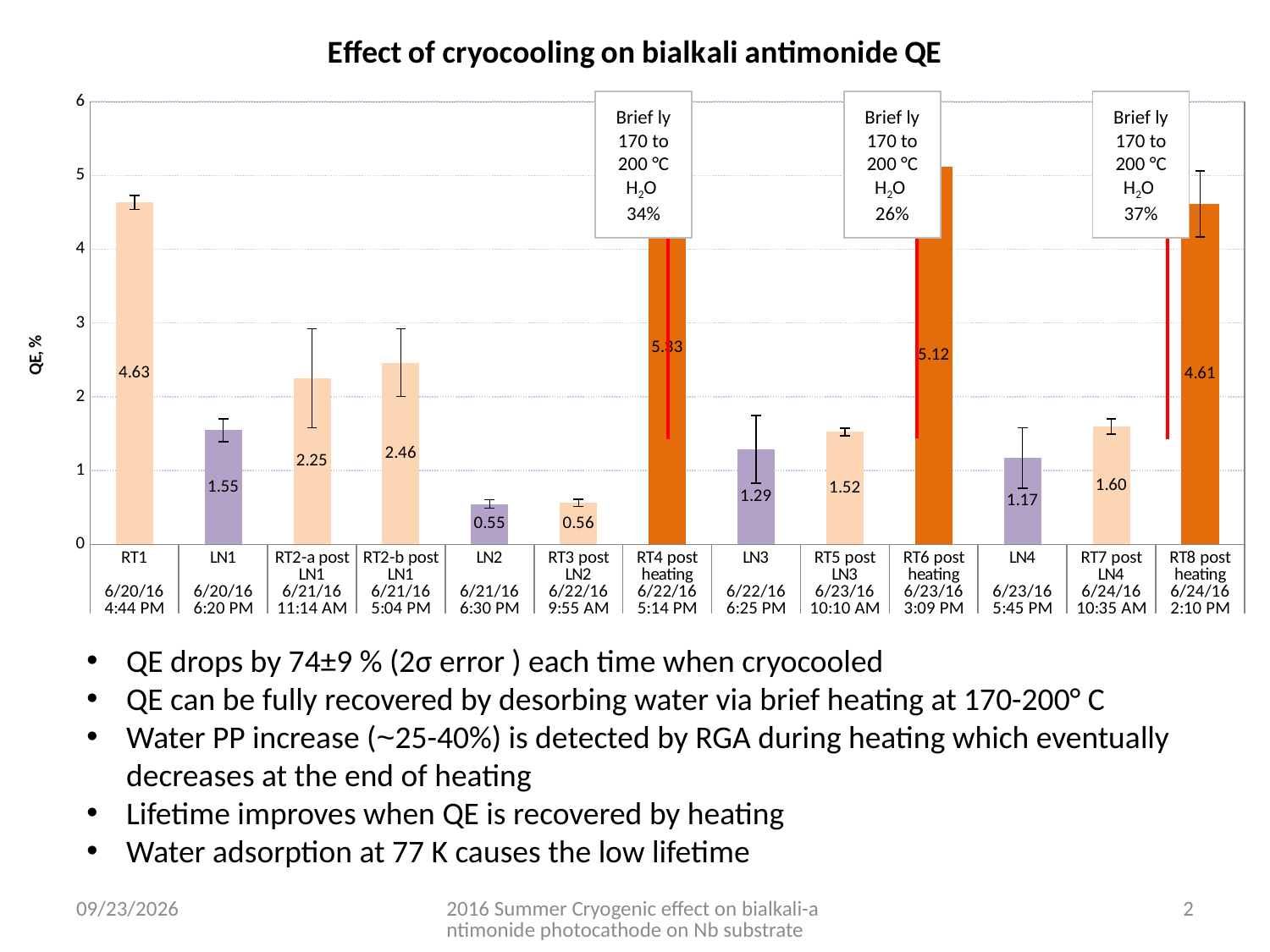
What is the QE value for RT1? 4.63 How many categories (bars) are shown on the x axis? 13 What is the difference in QE between RT1 and LN1? 3.08 What is the QE value for LN4? 1.17 What is the difference in QE between RT6 post heating and RT5 post LN3? 3.60 Which has a higher QE, RT2-a post LN1 or RT2-b post LN1? RT2-b post LN1 What is the QE value for RT6 post heating? 5.12 What kind of chart is shown on the slide? bar chart What is the QE value for RT8 post heating? 4.61 What is the QE value for RT3 post LN2? 0.56 What is the QE value for LN1? 1.55 Is the QE value for LN3 greater or less than 2? less